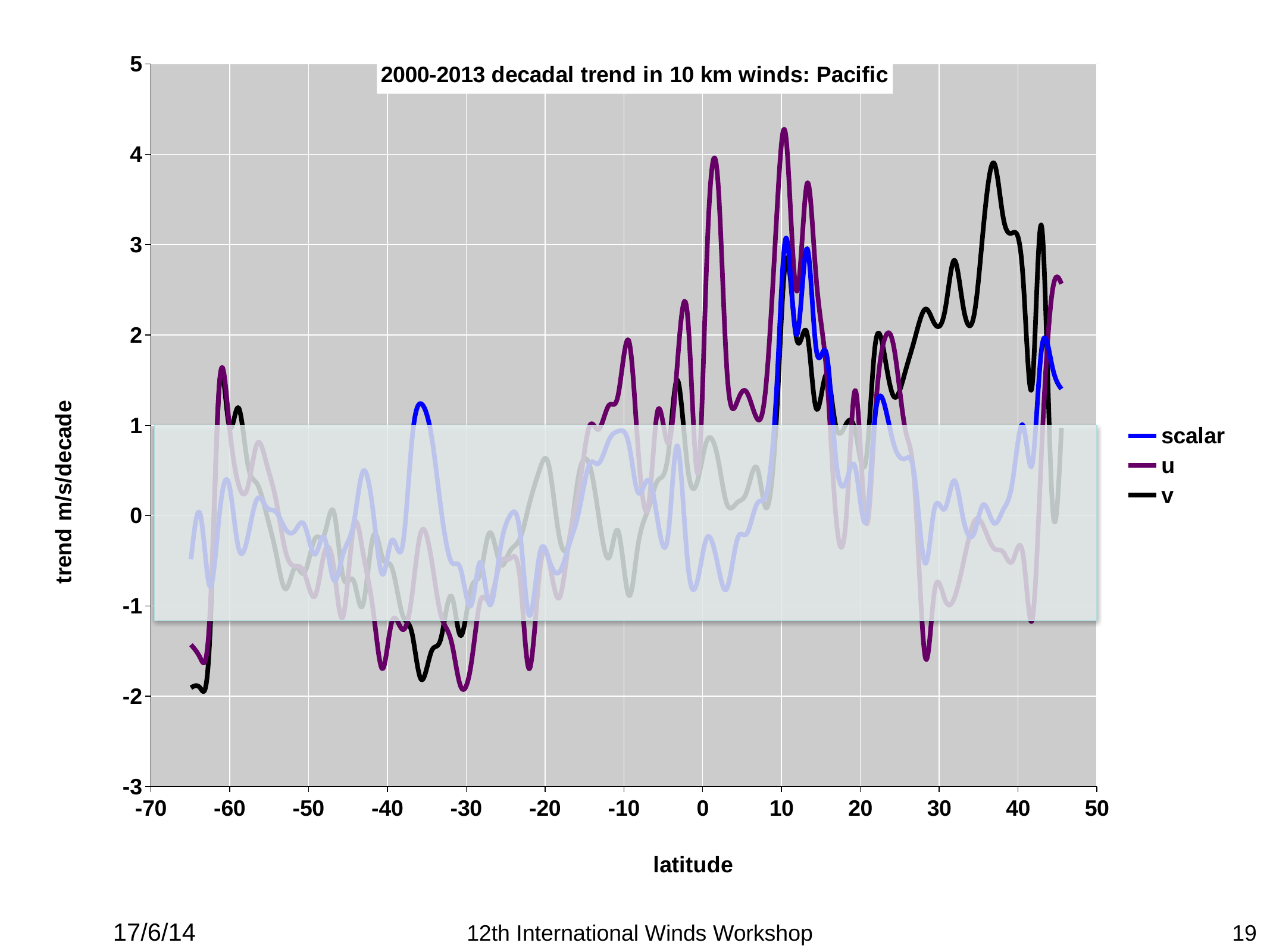
Is the peak value of the u series near latitude 10 greater or less than 4? greater What is the label of the y axis? trend m/s/decade What is the title of the chart? 2000-2013 decadal trend in 10 km winds: Pacific Which series reaches the highest value anywhere on the chart? u What kind of chart is shown on the slide? line chart How many series does the legend list? 3 Is the value of the v series near latitude -35 greater or less than -1? less Is the value of the u series near latitude -30 greater or less than -1? less At latitude 37, which series has the larger value, u or v? v Does the v series generally rise or fall between latitude 20 and latitude 37? rise At latitude 10, which series has the larger value, u or scalar? u